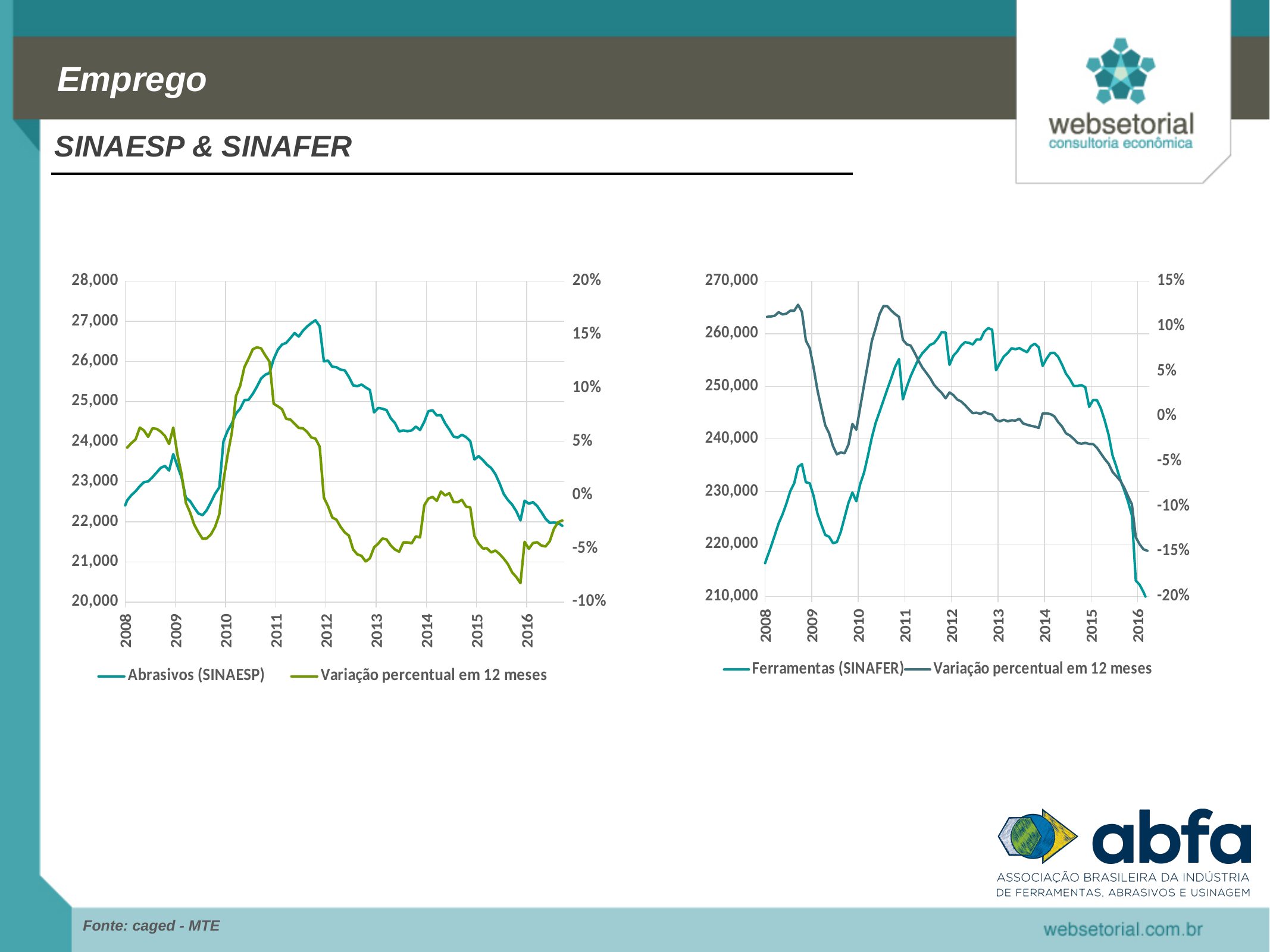
What kind of chart is the left chart (Abrasivos SINAESP)? line chart What source is cited at the bottom of the slide for the charts? caged - MTE On the right chart, does the Ferramentas (SINAFER) line rise or fall from 2013 to 2016? fall How many year labels are shown on the x axis of the left chart? 9 On the right chart, does the Ferramentas (SINAFER) line rise or fall from 2009 to 2012? rise On the right chart, is the Ferramentas (SINAFER) value at the start of 2008 greater or less than 220,000? less On the right chart, is the Variação percentual em 12 meses value at the end of 2016 greater or less than -10%? less On the left chart, does the Abrasivos (SINAESP) line rise or fall from 2012 to 2016? fall How many series does the legend of the right chart (Ferramentas SINAFER) list? 2 On the left chart, what are the two series named in the legend? Abrasivos (SINAESP) and Variação percentual em 12 meses On the left chart, is the peak of the Abrasivos (SINAESP) line in 2011 greater or less than 26,000? greater